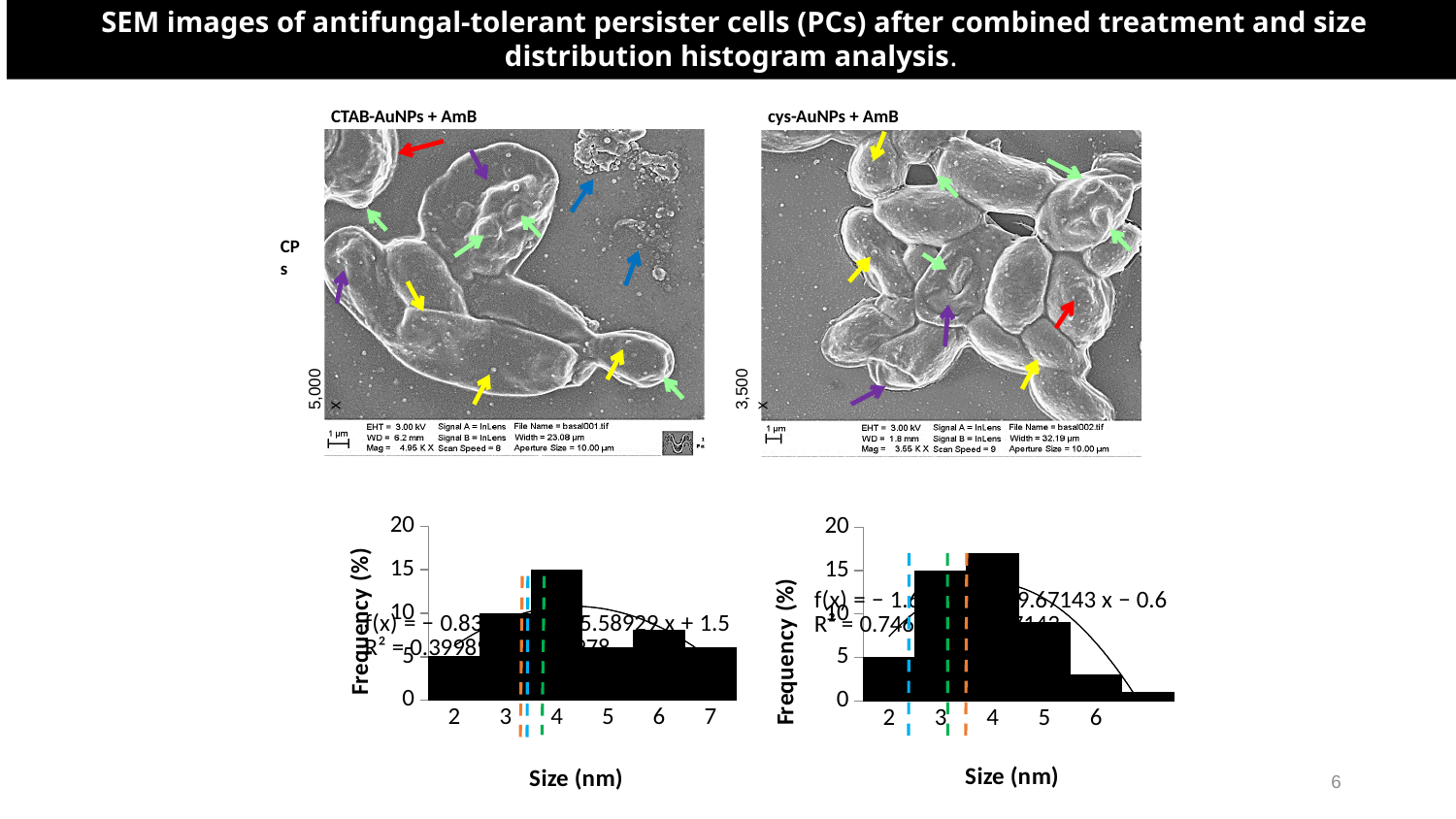
In the bottom-right histogram (cys-AuNPs + AmB), what is the frequency for size 2 nm? 5 In the bottom-left histogram (CTAB-AuNPs + AmB), what is the frequency for size 4 nm? 15 In the bottom-left histogram (CTAB-AuNPs + AmB), which size category has the highest frequency? 4 What is the y-axis label of the bottom-left histogram (CTAB-AuNPs + AmB)? Frequency (%) In the bottom-left histogram (CTAB-AuNPs + AmB), is the frequency for size 7 nm greater or less than 10? less In the bottom-left histogram (CTAB-AuNPs + AmB), which has the higher frequency, size 4 nm or size 7 nm? 4 What is the x-axis label of the bottom-right histogram (cys-AuNPs + AmB)? Size (nm) In the bottom-right histogram (cys-AuNPs + AmB), which size category has the highest frequency? 4 In the bottom-right histogram (cys-AuNPs + AmB), is the frequency for size 6 nm greater or less than 5? less What kind of chart is shown at the bottom left of the slide, under the CTAB-AuNPs + AmB image? bar chart In the bottom-right histogram (cys-AuNPs + AmB), is the frequency for size 4 nm greater or less than 15? greater In the bottom-right histogram (cys-AuNPs + AmB), which has the higher frequency, size 3 nm or size 6 nm? 3